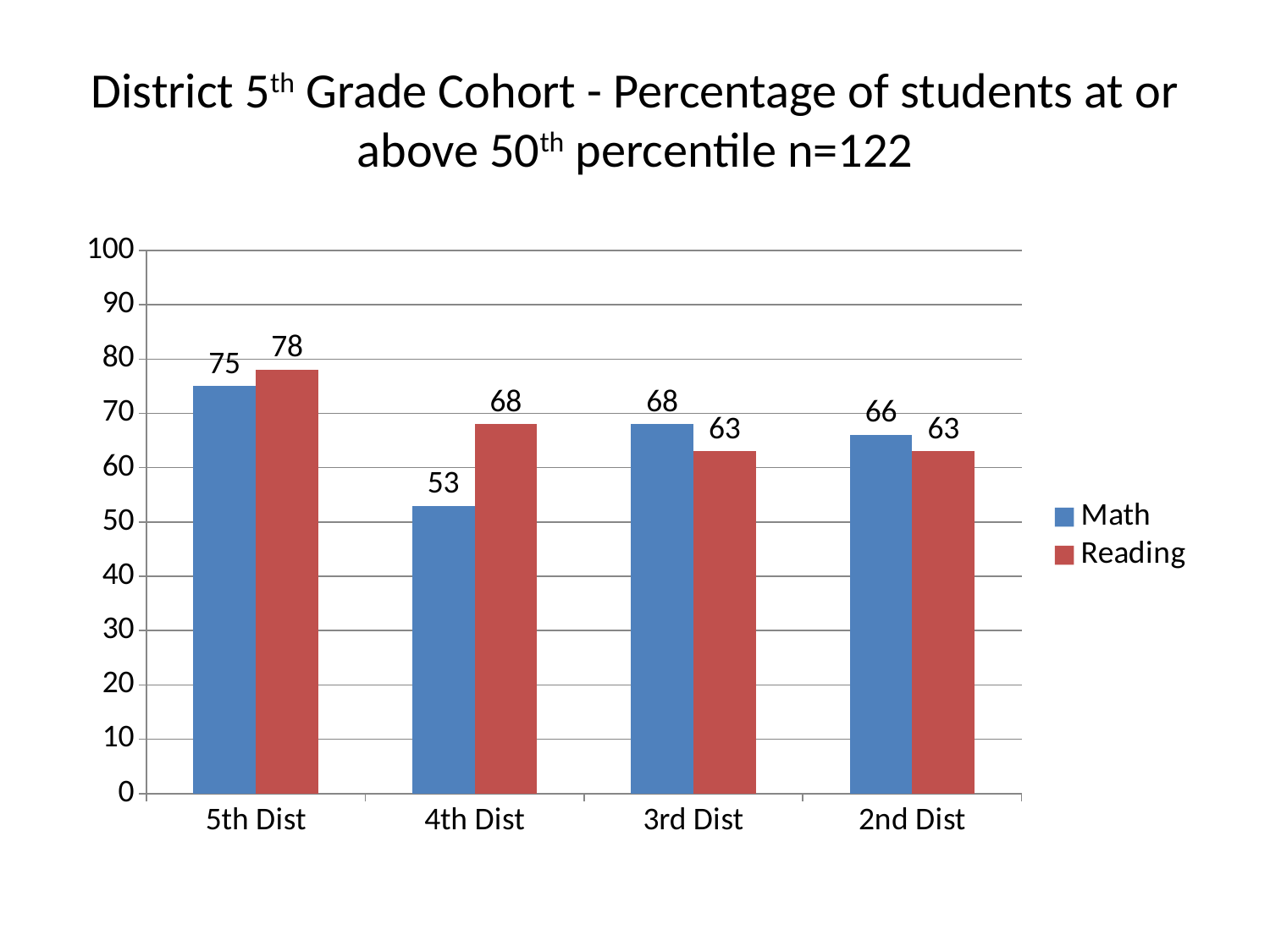
Which category has the lowest Math value? 4th Dist Which is larger for 3rd Dist, Math or Reading? Math What is the Math value for 5th Dist? 75 Which category has the highest Reading value? 5th Dist Which colour represents the Reading series? red Is the Math value for 4th Dist greater or less than 60? less What kind of chart is shown on the slide? bar chart What is the difference between the Reading and Math values for 4th Dist? 15 What is the Math value for 2nd Dist? 66 How many series does the legend list? 2 How many categories are shown on the x axis? 4 What is the Reading value for 4th Dist? 68